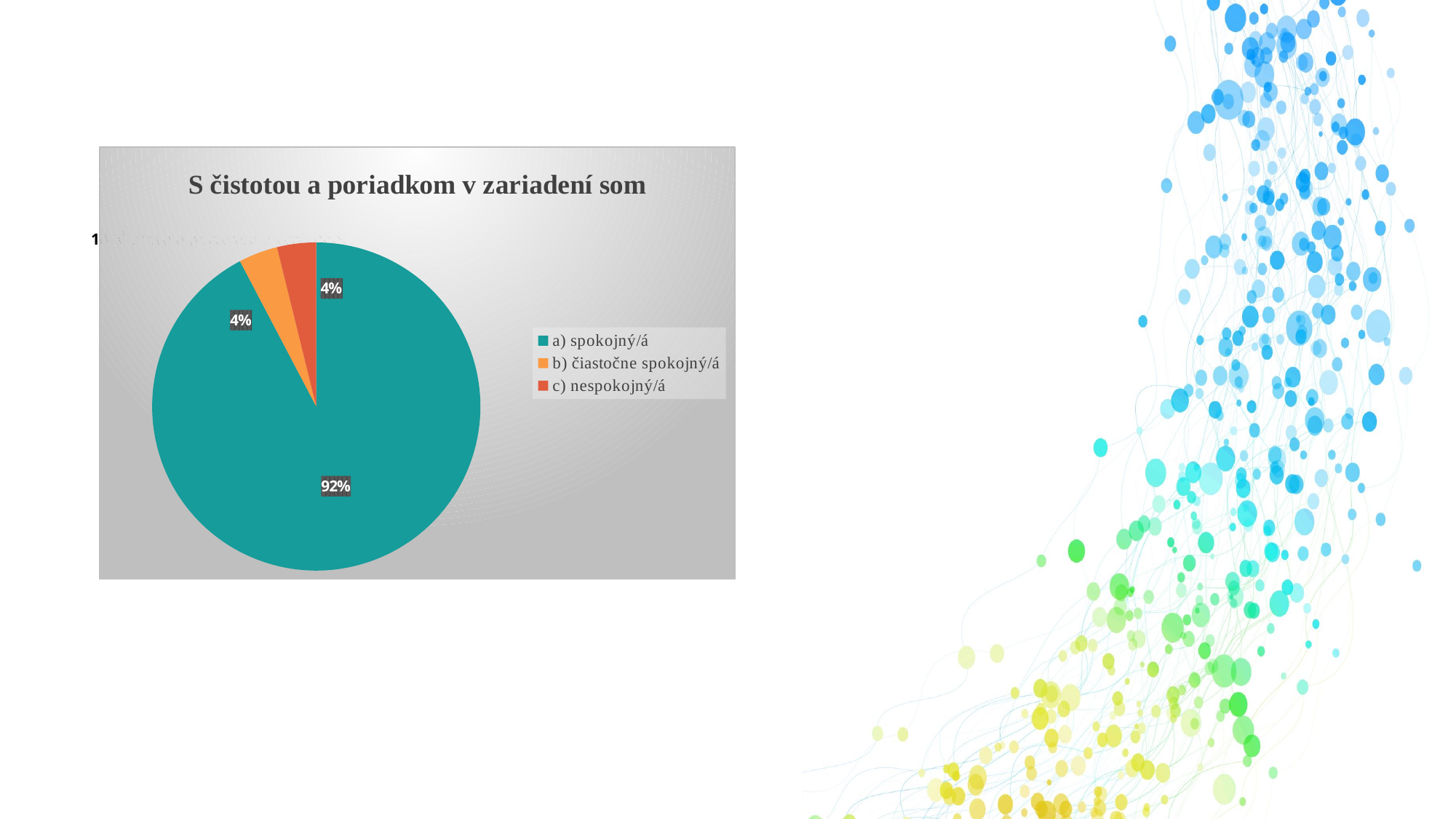
What is the combined share of b) čiastočne spokojný/á and c) nespokojný/á? 8% How many entries does the legend list? 3 How many slices does the pie chart have? 3 What share of the pie is labelled for c) nespokojný/á? 4% What is the difference in percentage points between the slice for a) spokojný/á and the slice for b) čiastočne spokojný/á? 88 Which category has the largest slice of the pie? a) spokojný/á What colour is the slice for a) spokojný/á? teal What share of the pie is labelled for b) čiastočne spokojný/á? 4% What is the title of the chart? S čistotou a poriadkom v zariadení som What kind of chart is shown on the slide? pie chart Which is larger, the slice for a) spokojný/á or the slice for c) nespokojný/á? a) spokojný/á What share of the pie is labelled for a) spokojný/á? 92%